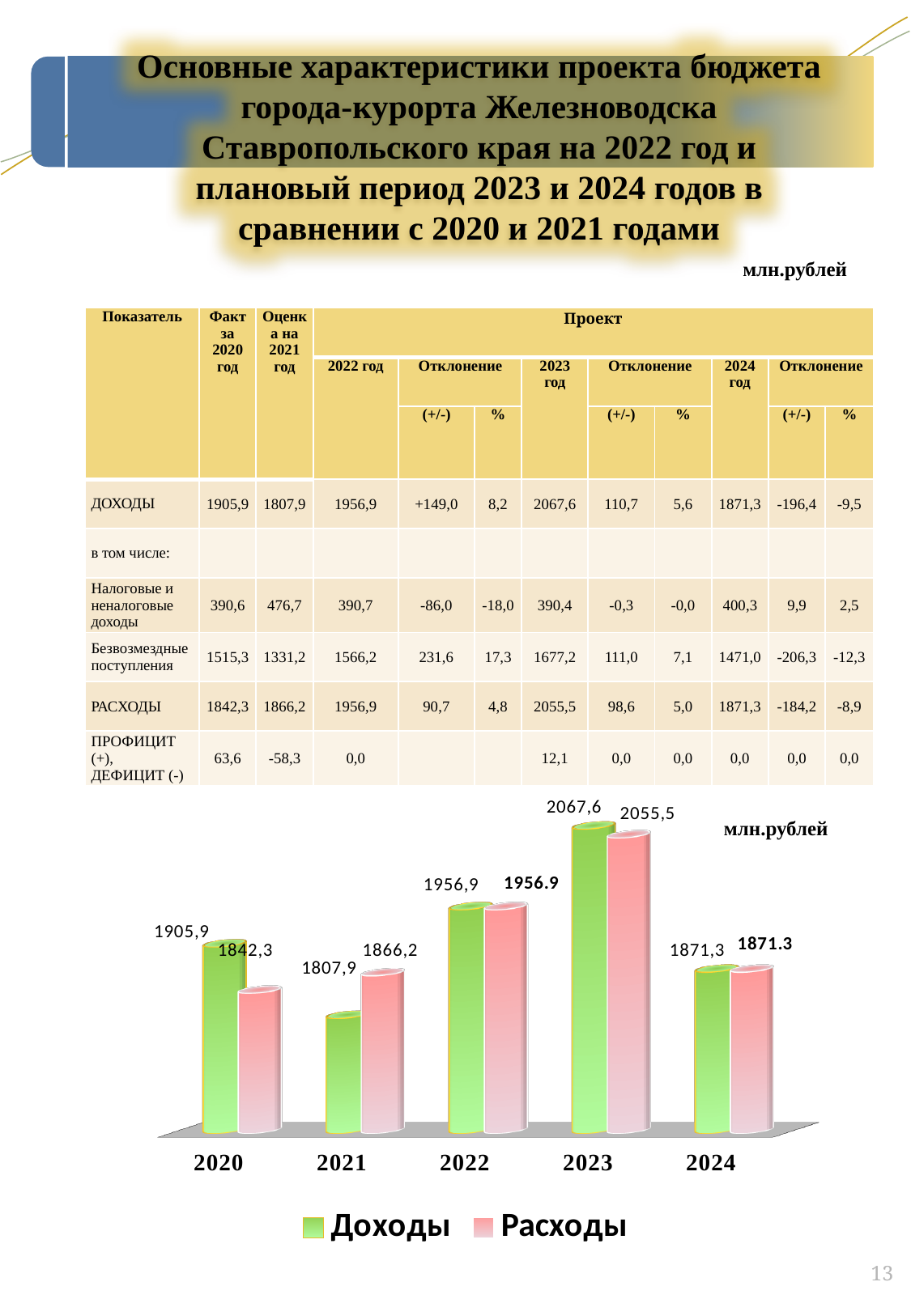
What is the value for Доходы in 2023? 2067,6 What kind of chart is shown on the slide? Bar chart How many series does the chart legend list? 2 In 2021, which is larger: Доходы or Расходы? Расходы What is the difference between Расходы and Доходы in 2021? 58,3 How many years are shown on the x axis of the chart? 5 What is the value for Доходы in 2020? 1905,9 In which year is Расходы lowest? 2020 In which year is Доходы lowest? 2021 In which year is Доходы highest? 2023 What is the value for Расходы in 2021? 1866,2 What is the difference between Доходы and Расходы in 2020? 63,6